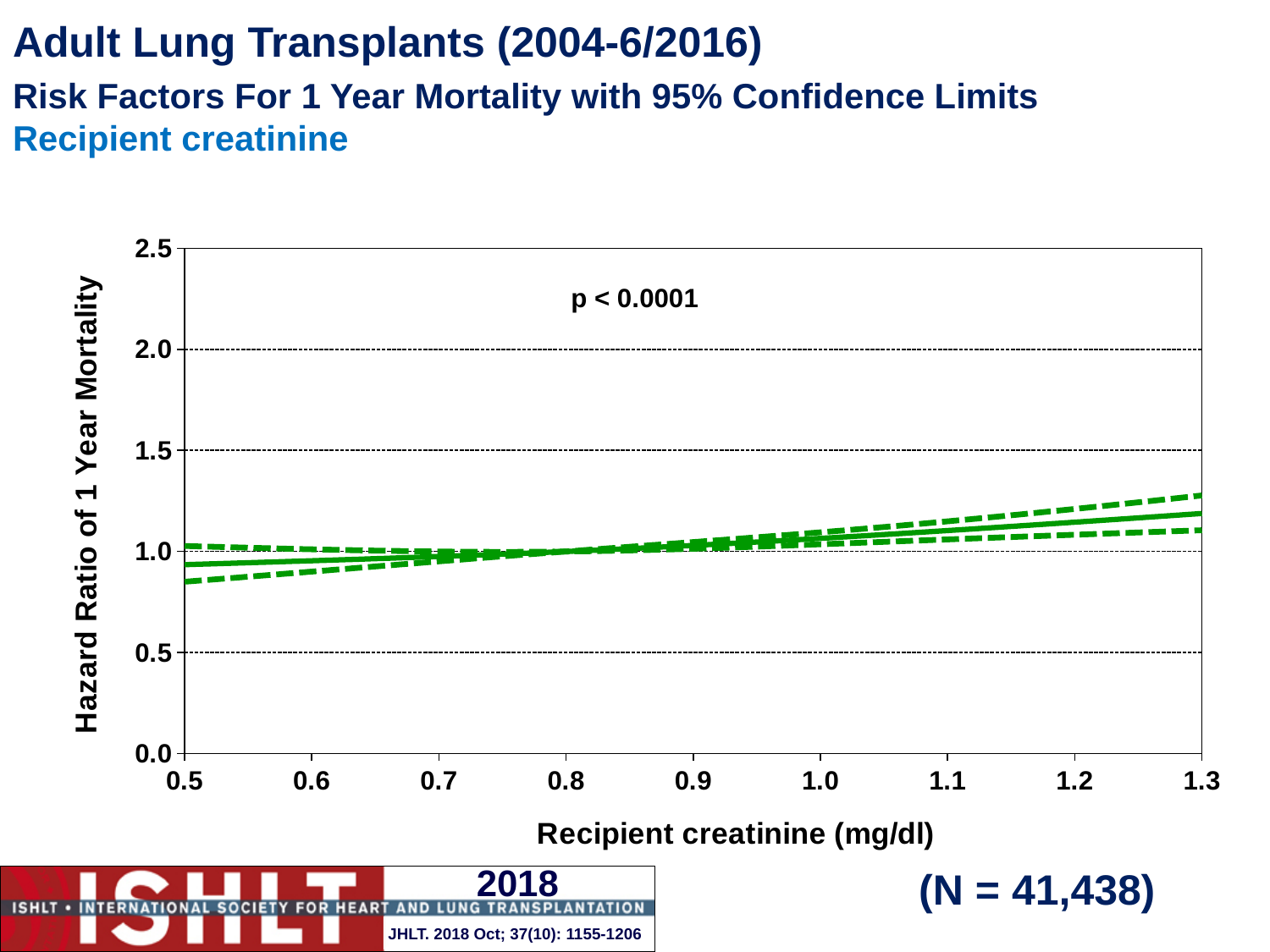
What kind of chart is shown on the slide? line chart How many tick values are labelled on the x axis? 9 At which recipient creatinine value shown on the x axis is the hazard ratio lowest? 0.5 Is the hazard ratio (solid line) at a recipient creatinine of 1.3 mg/dl greater or less than 1.0? greater Does the hazard ratio of 1 year mortality rise or fall as recipient creatinine increases from 0.5 to 1.3 mg/dl? rise Is the hazard ratio (solid line) at a recipient creatinine of 0.5 mg/dl greater or less than 1.0? less Is the lower 95% confidence limit at a recipient creatinine of 0.5 mg/dl greater or less than 1.0? less At which recipient creatinine value shown on the x axis is the hazard ratio highest? 1.3 How many lines (solid and dashed) are plotted on the chart? 3 What p-value is printed on the chart? p < 0.0001 What sample size (N) is shown on the slide? N = 41,438